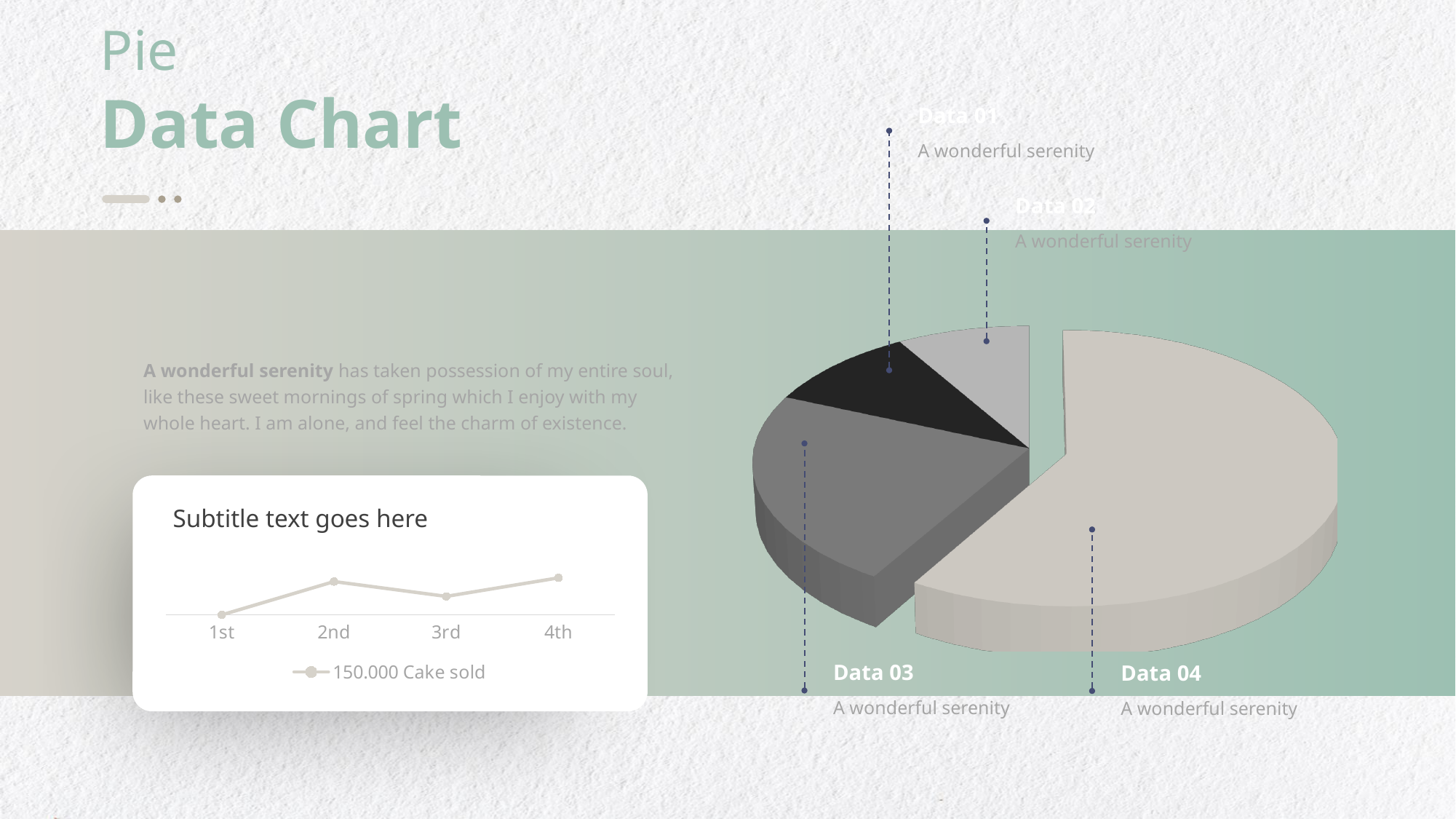
How many series does the legend of the line chart in the white box list? 1 In the pie chart on the right, which slice is larger, Data 04 or Data 03? Data 04 What kind of chart is shown in the white box on the lower left of the slide? Line chart In the pie chart on the right, which data label corresponds to the largest slice? Data 04 In the line chart in the white box, does the value rise or fall from 1st to 2nd? Rise How many data points are plotted in the line chart in the white box? 4 What is the legend entry of the line chart in the white box? 150.000 Cake sold In the line chart in the white box, which category has the lowest value? 1st What kind of chart is the large chart on the right side of the slide? Pie chart In the pie chart on the right, which slice is larger, Data 03 or Data 01? Data 03 In the line chart in the white box, which value is higher, 2nd or 3rd? 2nd How many slices does the pie chart on the right have? 4